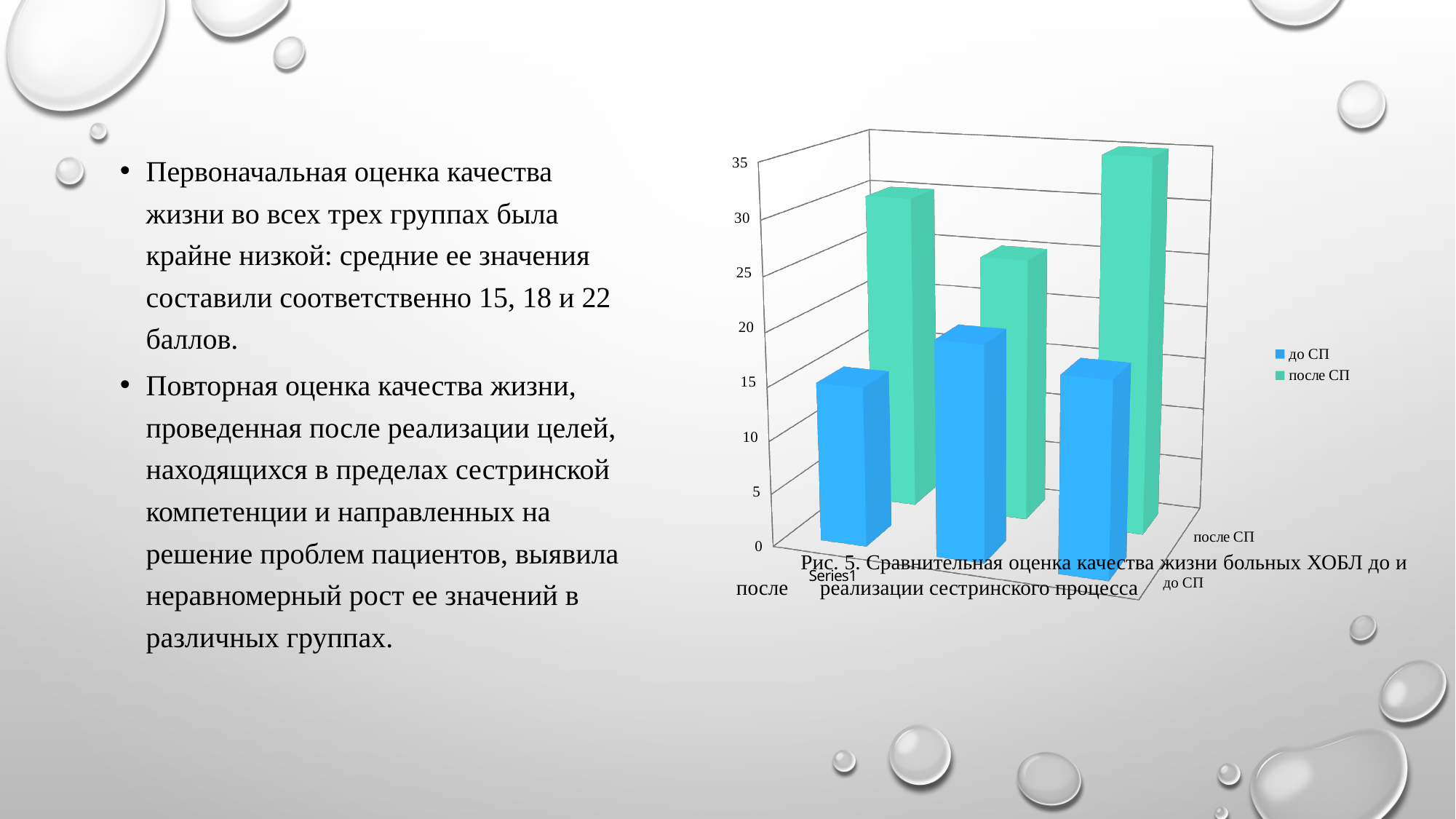
What is the highest value shown on the chart's vertical axis? 35 Is the value of the tallest после СП bar greater or less than 30? greater Which series has the shortest bar in the chart? до СП What kind of chart is shown on the slide? bar chart Is the value of the leftmost до СП bar greater or less than 25? less How many series does the chart legend list? 2 How many groups of bars are plotted in the chart? 3 Which series has the tallest bar in the chart? после СП In the middle group of bars, which series is larger: до СП or после СП? после СП What are the two series named in the chart legend? до СП and после СП In the first (leftmost) group of bars, which series is larger: до СП or после СП? после СП